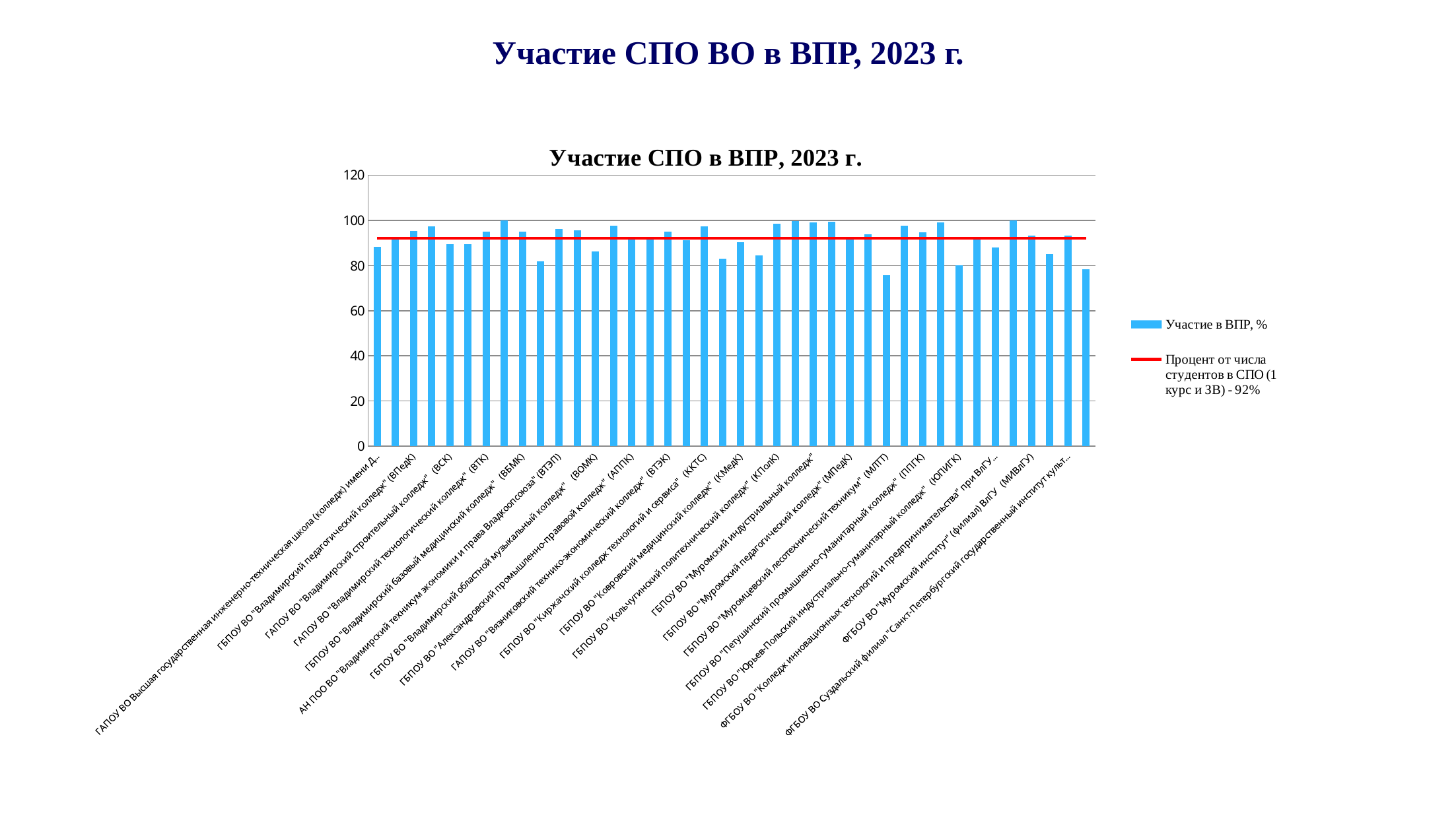
Is the value for ГБПОУ ВО "Владимирский базовый медицинский колледж" (ВБМК) greater or less than 80? greater What kind of chart is shown on the slide? combination bar and line chart What is the title of the chart? Участие СПО в ВПР, 2023 г. What is the name of the series shown as blue bars? Участие в ВПР, % How many series does the chart legend list? 2 Is the value for ГБПОУ ВО "Владимирский педагогический колледж" (ВПедК) greater or less than 60? greater Is the value for ГБПОУ ВО "Ковровский медицинский колледж" (КМедК) greater or less than 40? greater What percentage does the red line in the chart represent, according to the legend? 92%